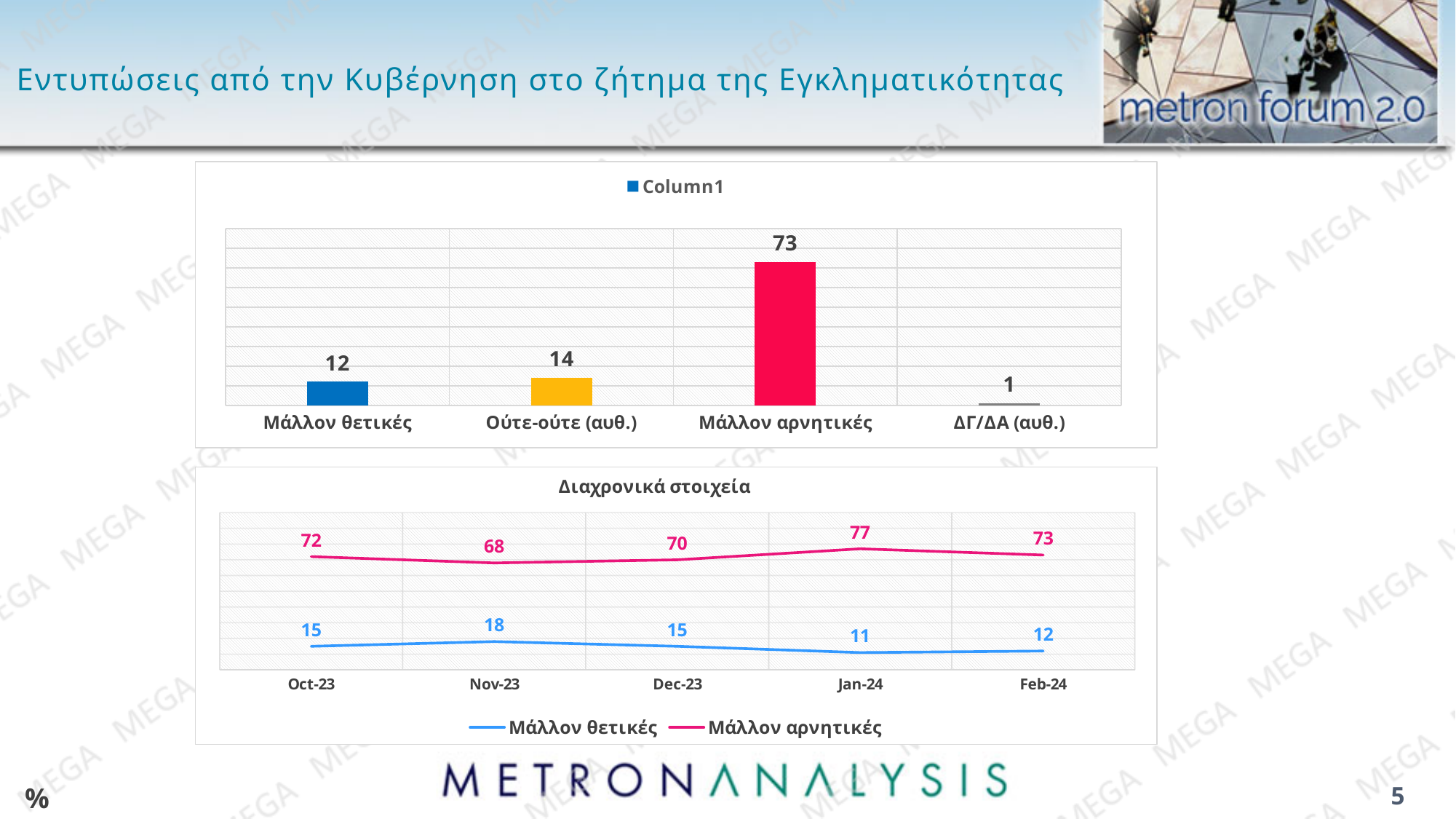
In the top bar chart, what is the value for Μάλλον αρνητικές? 73 In the top bar chart, how many categories are shown? 4 In the Διαχρονικά στοιχεία chart, how many series does the legend list? 2 In the top bar chart, what is the value for Ούτε-ούτε (αυθ.)? 14 In the Διαχρονικά στοιχεία chart, what is the value for Μάλλον θετικές in Nov-23? 18 In the Διαχρονικά στοιχεία chart, what is the difference between Μάλλον αρνητικές and Μάλλον θετικές in Feb-24? 61 In the Διαχρονικά στοιχεία chart, what is the value for Μάλλον αρνητικές in Jan-24? 77 In the top bar chart, what is the difference between Μάλλον αρνητικές and Μάλλον θετικές? 61 What type of chart is the top chart on the slide? Bar chart In the Διαχρονικά στοιχεία chart, in which month is Μάλλον αρνητικές highest? Jan-24 In the Διαχρονικά στοιχεία chart, which series is drawn in blue? Μάλλον θετικές In the top bar chart, which category has the lowest value? ΔΓ/ΔΑ (αυθ.)